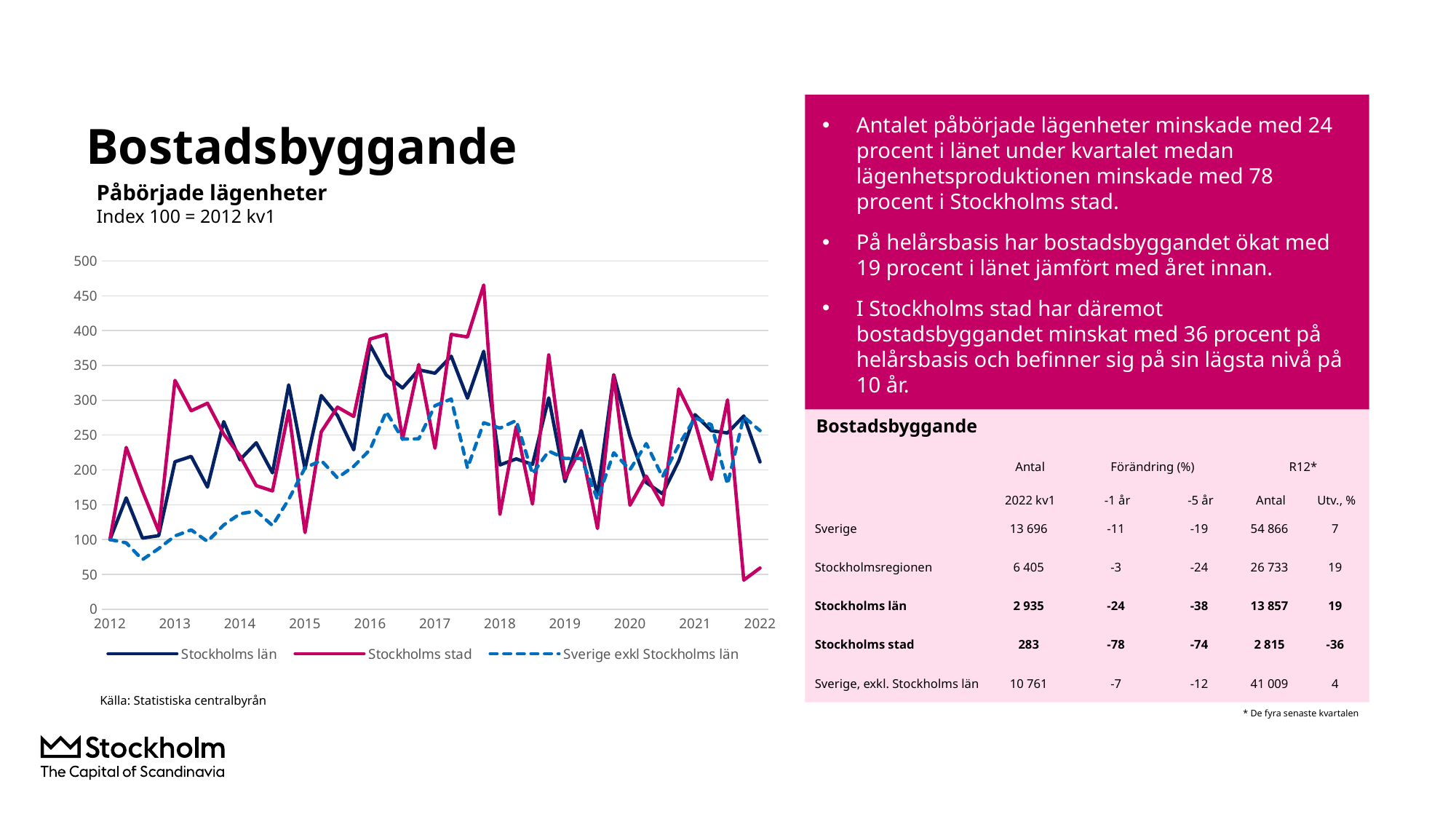
What is the title of the chart? Påbörjade lägenheter What kind of chart is shown on the slide? line chart Is the peak value for Stockholms stad in 2017 greater or less than 450? greater Which series in the chart is drawn with a dashed line? Sverige exkl Stockholms län Which series reaches the highest value anywhere on the chart? Stockholms stad Is the lowest value for Stockholms stad near the end of the chart (around 2022) greater or less than 100? less How many series does the chart legend list? 3 Does the Stockholms stad series rise or fall between 2021 and 2022? fall Is the lowest value for Sverige exkl Stockholms län in 2012 greater or less than 100? less At the last point on the chart (2022), which series is higher: Stockholms län or Stockholms stad? Stockholms län How many year labels are shown on the x axis of the chart? 11